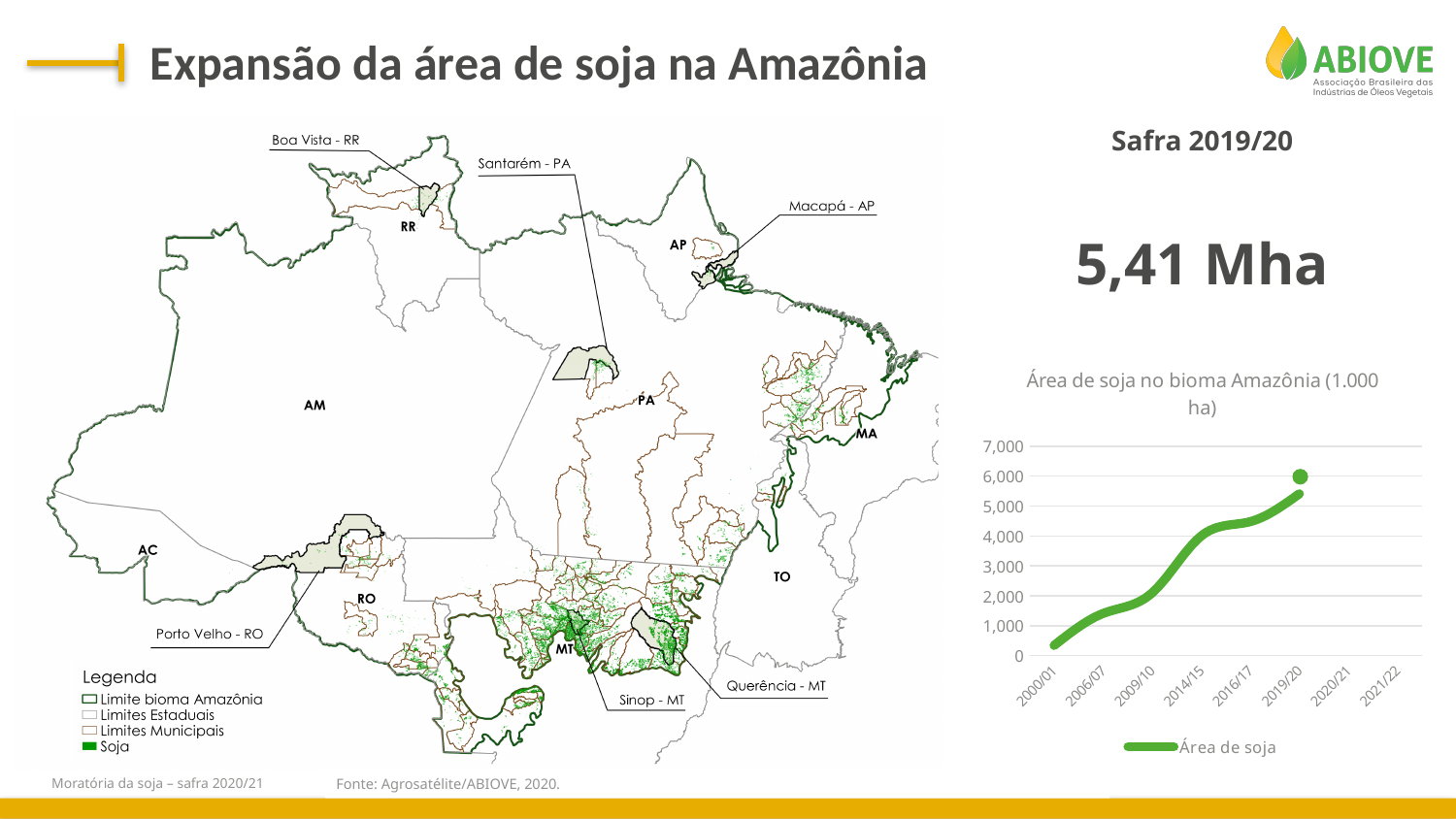
In the line chart 'Área de soja no bioma Amazônia (1.000 ha)', is the value for 2000/01 greater or less than 1,000? less In the line chart 'Área de soja no bioma Amazônia (1.000 ha)', which is larger, the value for 2019/20 or the value for 2006/07? 2019/20 What is the highest tick value shown on the y axis of the line chart 'Área de soja no bioma Amazônia (1.000 ha)'? 7,000 How many season labels are shown on the x axis of the line chart 'Área de soja no bioma Amazônia (1.000 ha)'? 8 In the line chart 'Área de soja no bioma Amazônia (1.000 ha)', is the value for 2016/17 greater or less than 4,000? greater What is the name of the series in the legend of the line chart 'Área de soja no bioma Amazônia (1.000 ha)'? Área de soja In the line chart 'Área de soja no bioma Amazônia (1.000 ha)', is the value for 2006/07 greater or less than 2,000? less In the line chart 'Área de soja no bioma Amazônia (1.000 ha)', which season has the lowest value? 2000/01 What kind of chart is shown under the heading 'Área de soja no bioma Amazônia (1.000 ha)'? line chart How many series does the legend of the line chart 'Área de soja no bioma Amazônia (1.000 ha)' list? 1 In the line chart 'Área de soja no bioma Amazônia (1.000 ha)', do the values rise or fall from 2000/01 to 2019/20? rise